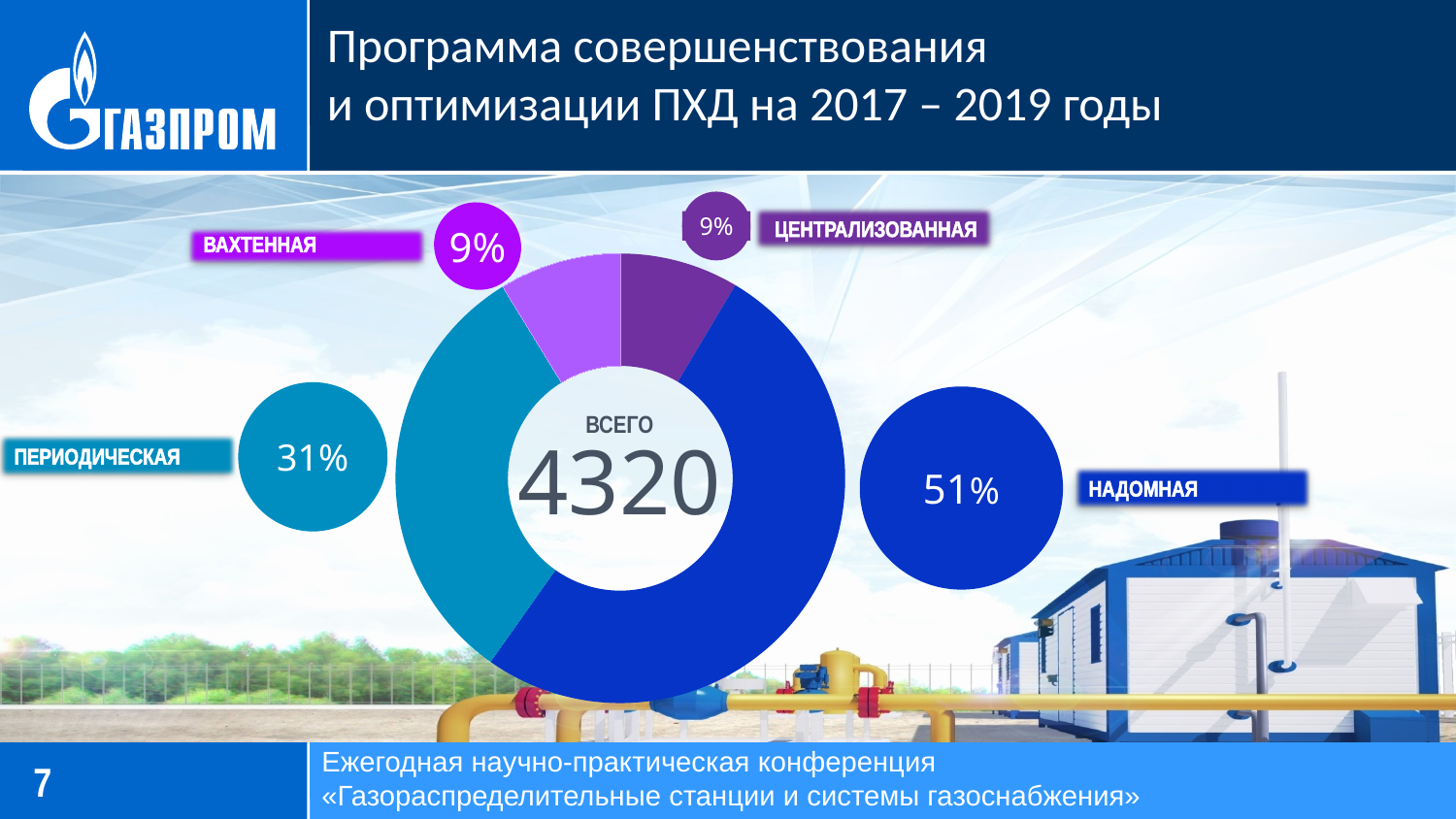
What is the total value shown in the centre of the chart (ВСЕГО)? 4320 What is the difference in share between НАДОМНАЯ and ПЕРИОДИЧЕСКАЯ? 20 percentage points What label appears in the centre of the donut above the number 4320? ВСЕГО What share does the ВАХТЕННАЯ segment have? 9% Which has the larger share, ПЕРИОДИЧЕСКАЯ or ВАХТЕННАЯ? ПЕРИОДИЧЕСКАЯ What kind of chart is shown on the slide? Donut (pie) chart What share does the ЦЕНТРАЛИЗОВАННАЯ segment have? 9% What share does the ПЕРИОДИЧЕСКАЯ segment have? 31% How many segments does the donut chart have? 4 What is the combined share of ВАХТЕННАЯ and ЦЕНТРАЛИЗОВАННАЯ? 18% What share does the НАДОМНАЯ segment have? 51% Which segment has the largest share? НАДОМНАЯ